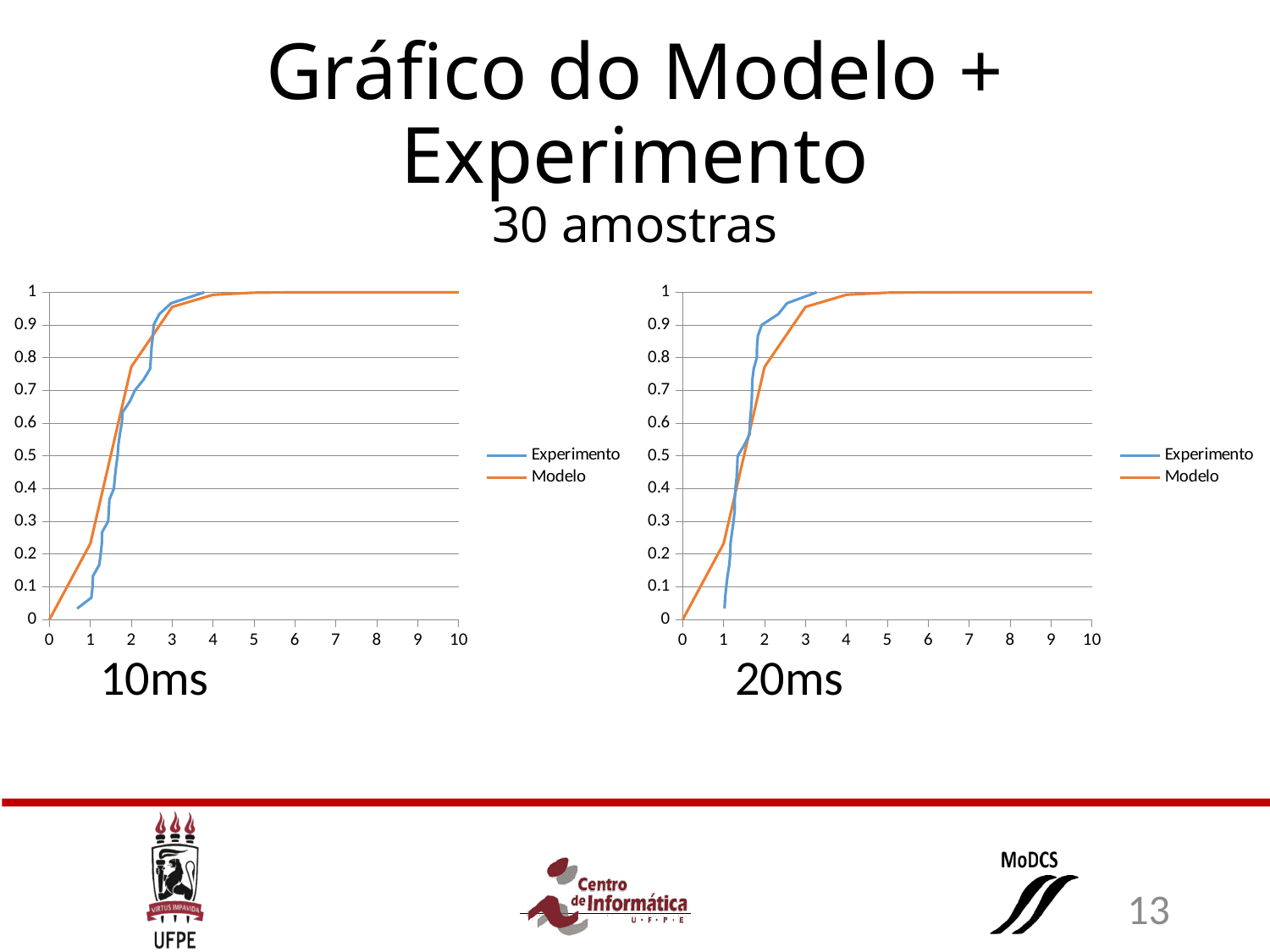
In the 10ms chart, do the values of the Experimento line rise or fall as x increases? rise In the 10ms chart, what value does the Modelo line level off at for x from 5 to 10? 1 In the 10ms chart, is the value of the Experimento line at x = 2 greater or less than 0.5? greater What kind of chart is the 10ms chart on the left? line chart In the 20ms chart, is the value of the Modelo line at x = 1 greater or less than 0.5? less How many charts are shown on the slide? 2 In the 20ms chart, do the values of the Modelo line rise or fall as x increases? rise How many series does the legend of the 20ms chart list? 2 In the 10ms chart, at x = 1, which series has the larger value, Experimento or Modelo? Modelo In the 20ms chart, is the value of the Experimento line at x = 2 greater or less than 0.8? greater What are the two series named in the legend of the 10ms chart? Experimento and Modelo In the 20ms chart, at x = 2, which series has the larger value, Experimento or Modelo? Experimento